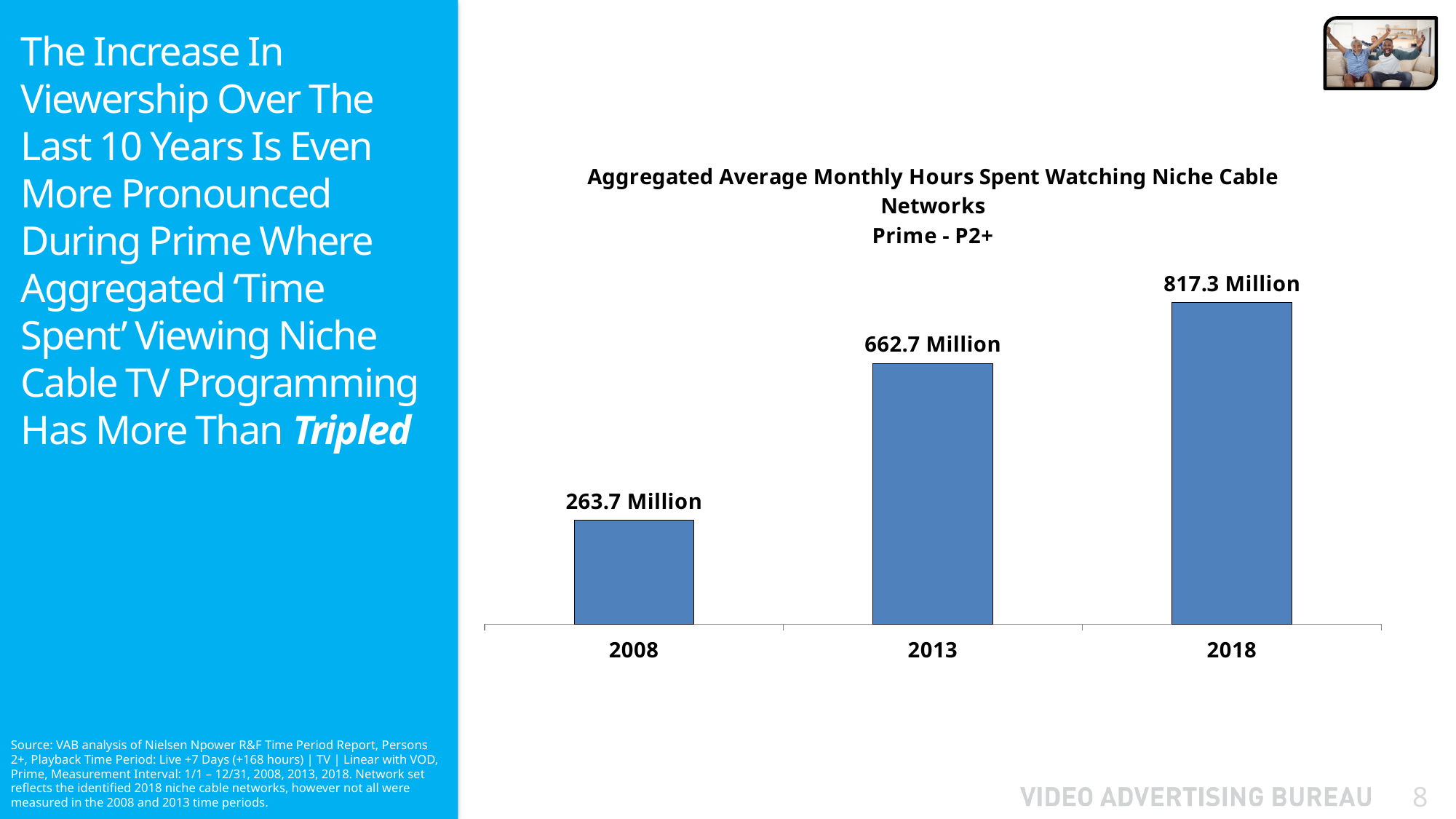
What is the difference between the 2013 and 2008 values? 399.0 Million Which year has the highest value? 2018 Which year has the lowest value? 2008 What is the difference between the 2018 and 2008 values? 553.6 Million How many years are shown on the x axis? 3 What is the value for 2013? 662.7 Million What is the title of the chart? Aggregated Average Monthly Hours Spent Watching Niche Cable Networks Prime - P2+ What is the value for 2008? 263.7 Million Which is larger, the value for 2013 or the value for 2018? 2018 What kind of chart is shown? Bar chart Do the values rise or fall from 2008 to 2018? Rise What is the value for 2018? 817.3 Million